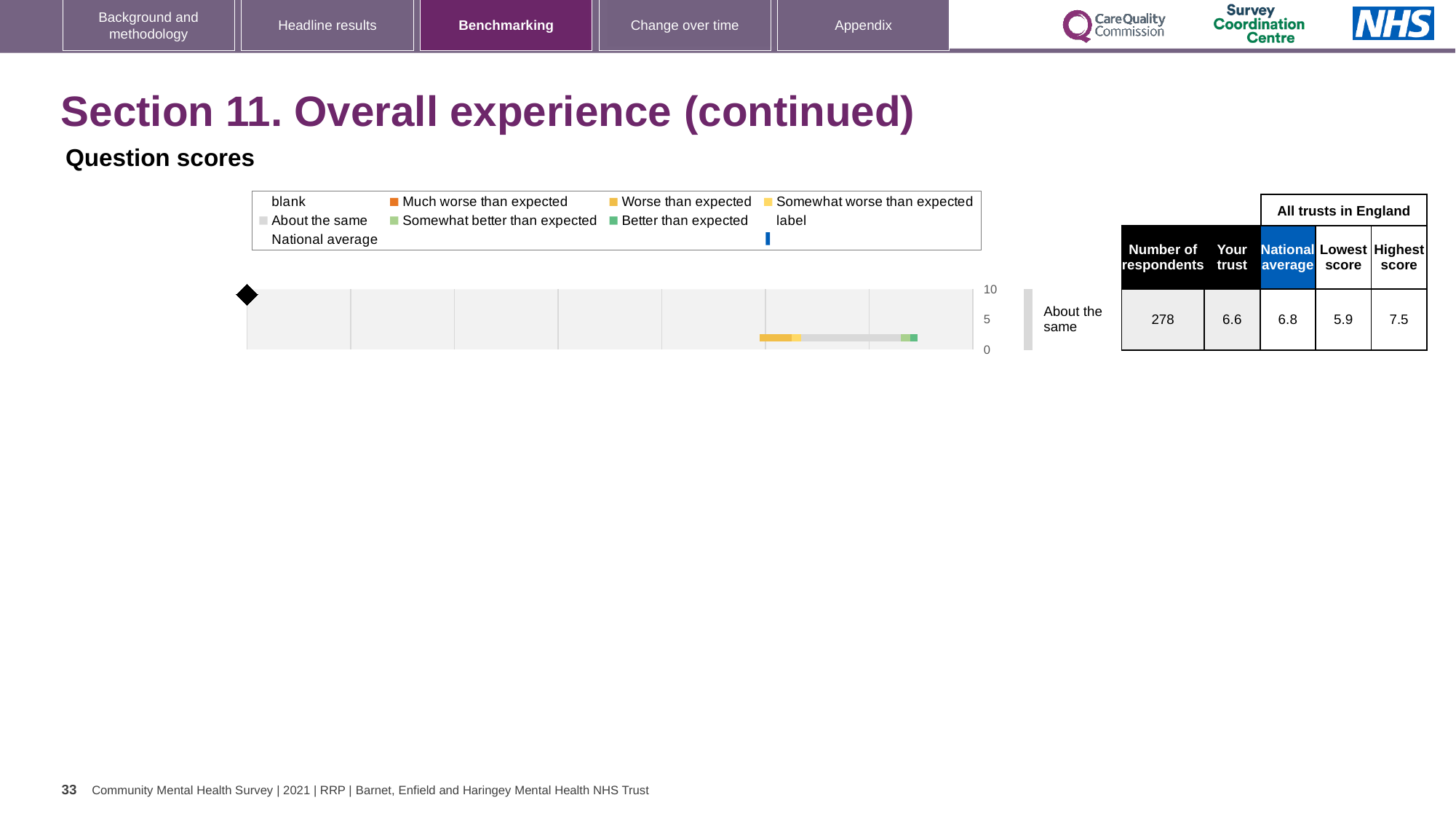
Is the 'Your trust' score for 'About the same' greater or less than 5? greater According to the table beside the chart, what is the 'Your trust' score for 'About the same'? 6.6 What is the difference between the highest score (7.5) and the lowest score (5.9) shown in the table beside the chart? 1.6 According to the table beside the chart, what is the national average score for 'About the same'? 6.8 According to the table beside the chart, how many respondents answered the 'About the same' question? 278 How many question categories are plotted in the chart? 1 What kind of chart is shown on the slide? bar chart According to the table beside the chart, what is the lowest score among all trusts in England? 5.9 According to the table beside the chart, what is the highest score among all trusts in England? 7.5 Which legend entry is shown in orange? Much worse than expected What is the category label of the single bar in the chart? About the same Which is larger for 'About the same': the 'Your trust' score or the national average? National average